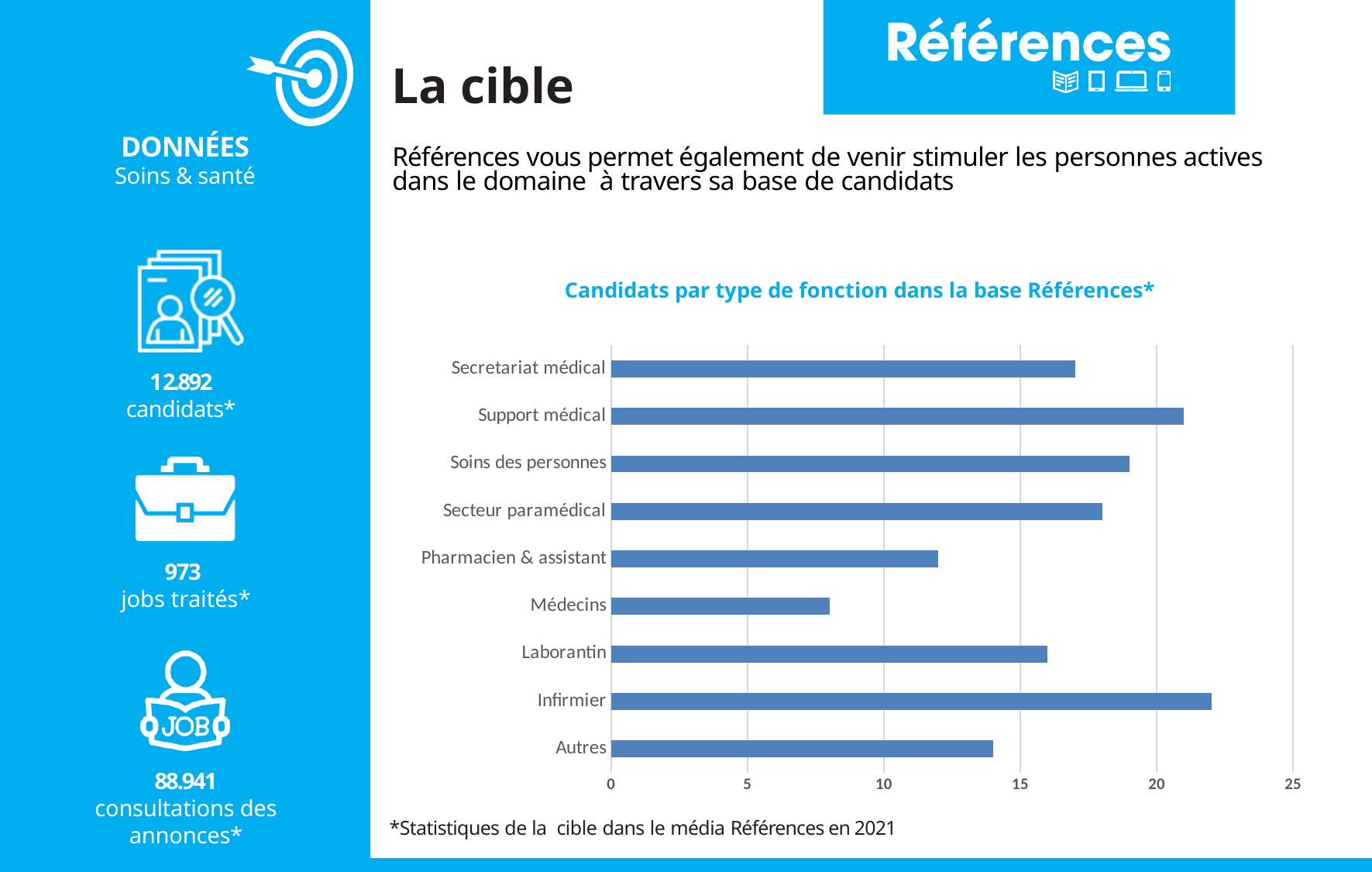
Which category has the highest number of candidates? Infirmier Is the value for Médecins greater or less than 10? less What is the title of the chart? Candidats par type de fonction dans la base Références* Which category has the lowest number of candidates? Médecins What kind of chart is shown on the slide? Bar chart How many function categories are plotted in the chart? 9 Which is larger, the value for Support médical or the value for Secretariat médical? Support médical Is the value for Infirmier greater or less than 20? greater Which is larger, the value for Soins des personnes or the value for Pharmacien & assistant? Soins des personnes Is the value for Autres greater or less than 15? less